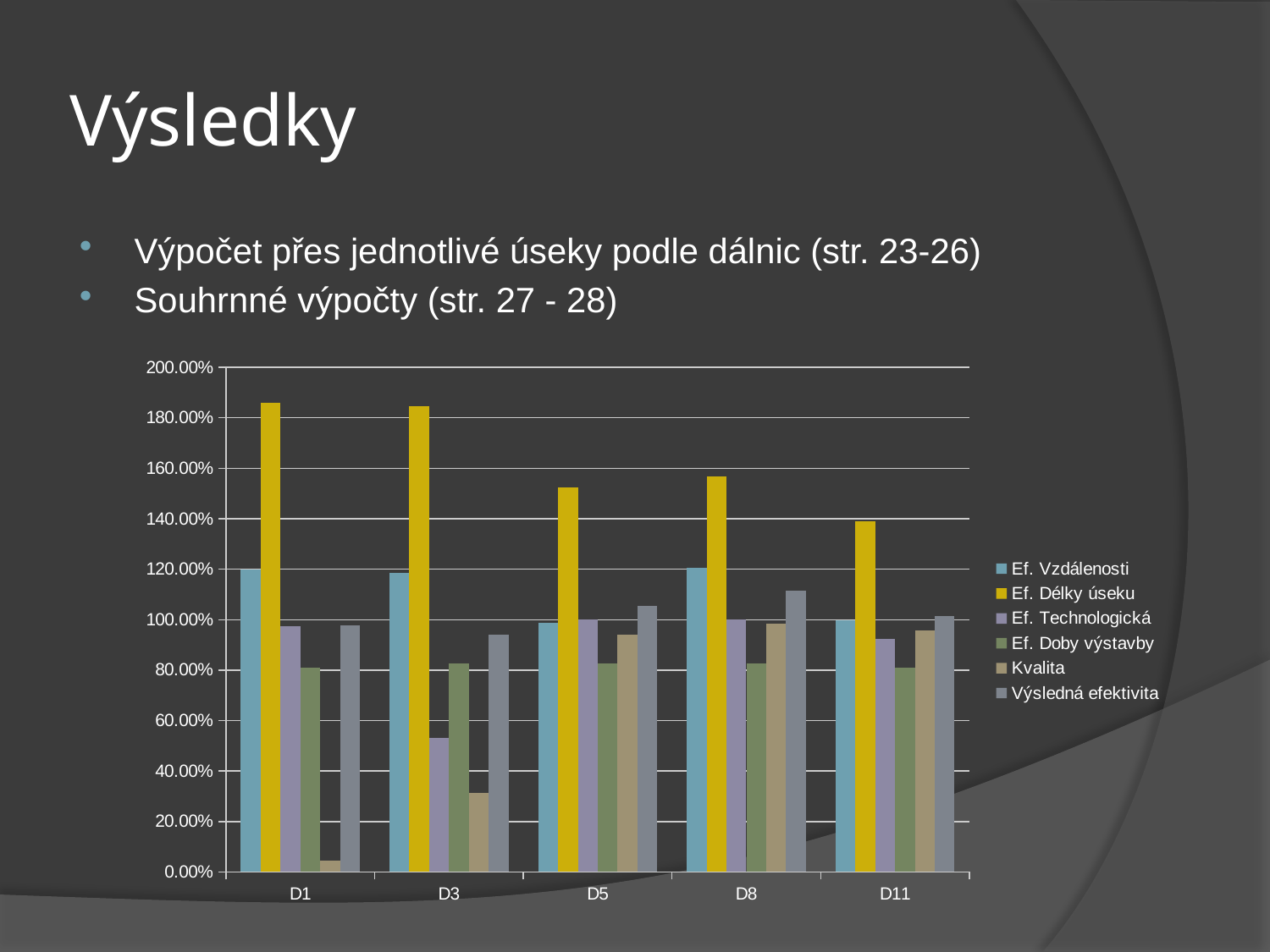
What kind of chart is shown on the slide? Bar chart How many categories (motorways) are shown on the x axis of the chart? 5 Is the Kvalita value for D3 greater or less than 40.00%? less For which category is the Ef. Délky úseku bar the lowest? D11 What colour represents the Ef. Délky úseku series in the chart? Yellow Is the Ef. Délky úseku value for D5 greater or less than 140.00%? greater For which category is the Kvalita bar the lowest? D1 For which category is the Výsledná efektivita bar the highest? D8 Is the Ef. Doby výstavby value for D1 greater or less than 100.00%? less How many series does the chart's legend list? 6 Which has the larger Ef. Technologická value, D1 or D3? D1